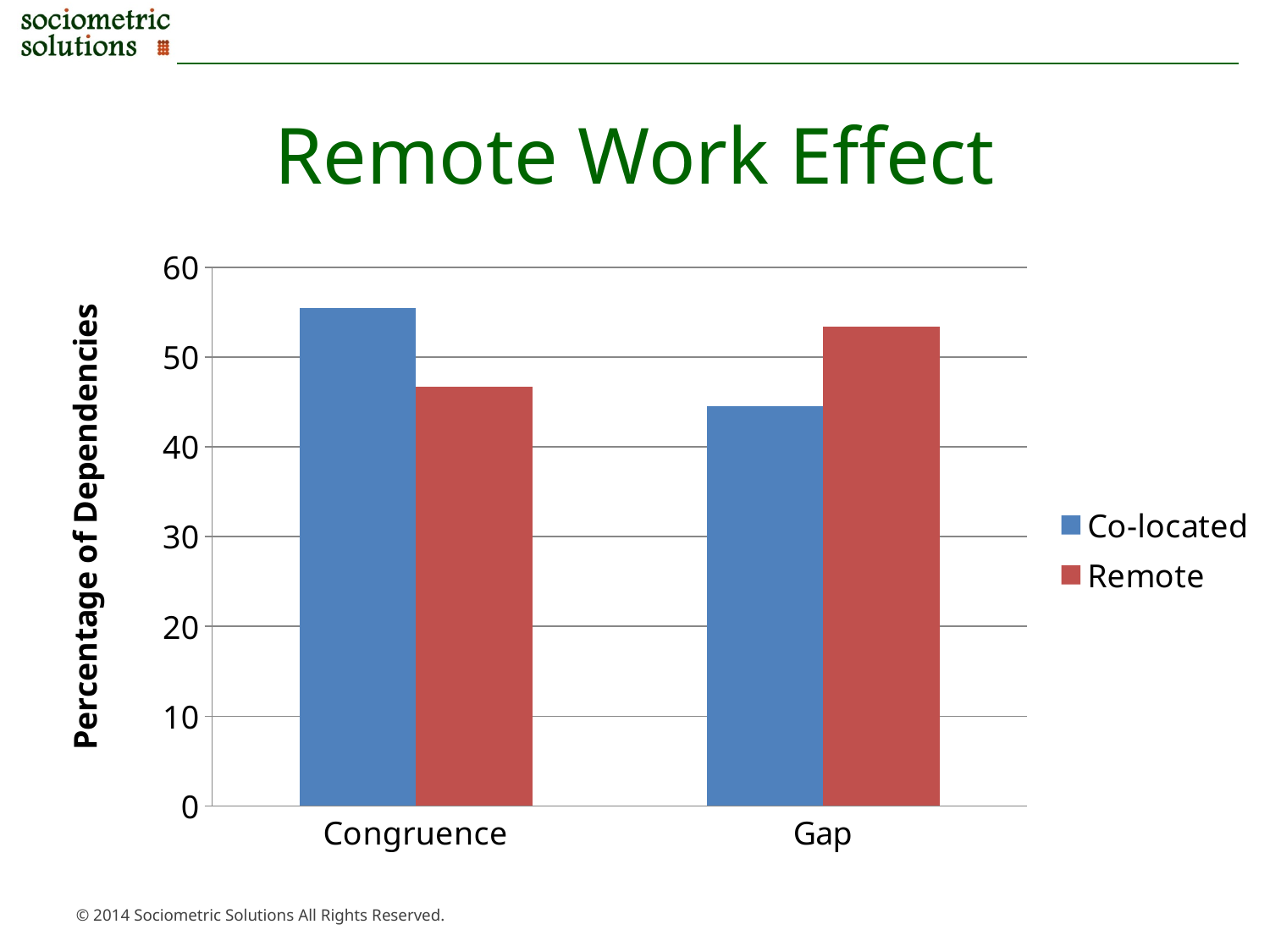
Is the Co-located value for Congruence greater or less than 50? greater What is the title of the chart? Remote Work Effect For Gap, which series has the larger value, Co-located or Remote? Remote Is the Remote value for Gap greater or less than 50? greater What is the label on the vertical axis of the chart? Percentage of Dependencies Is the Remote value for Congruence greater or less than 50? less What kind of chart is shown on the slide? Bar chart How many series does the legend list? 2 For the Co-located series, which category has the larger value, Congruence or Gap? Congruence How many categories are shown on the x axis? 2 For Congruence, which series has the larger value, Co-located or Remote? Co-located